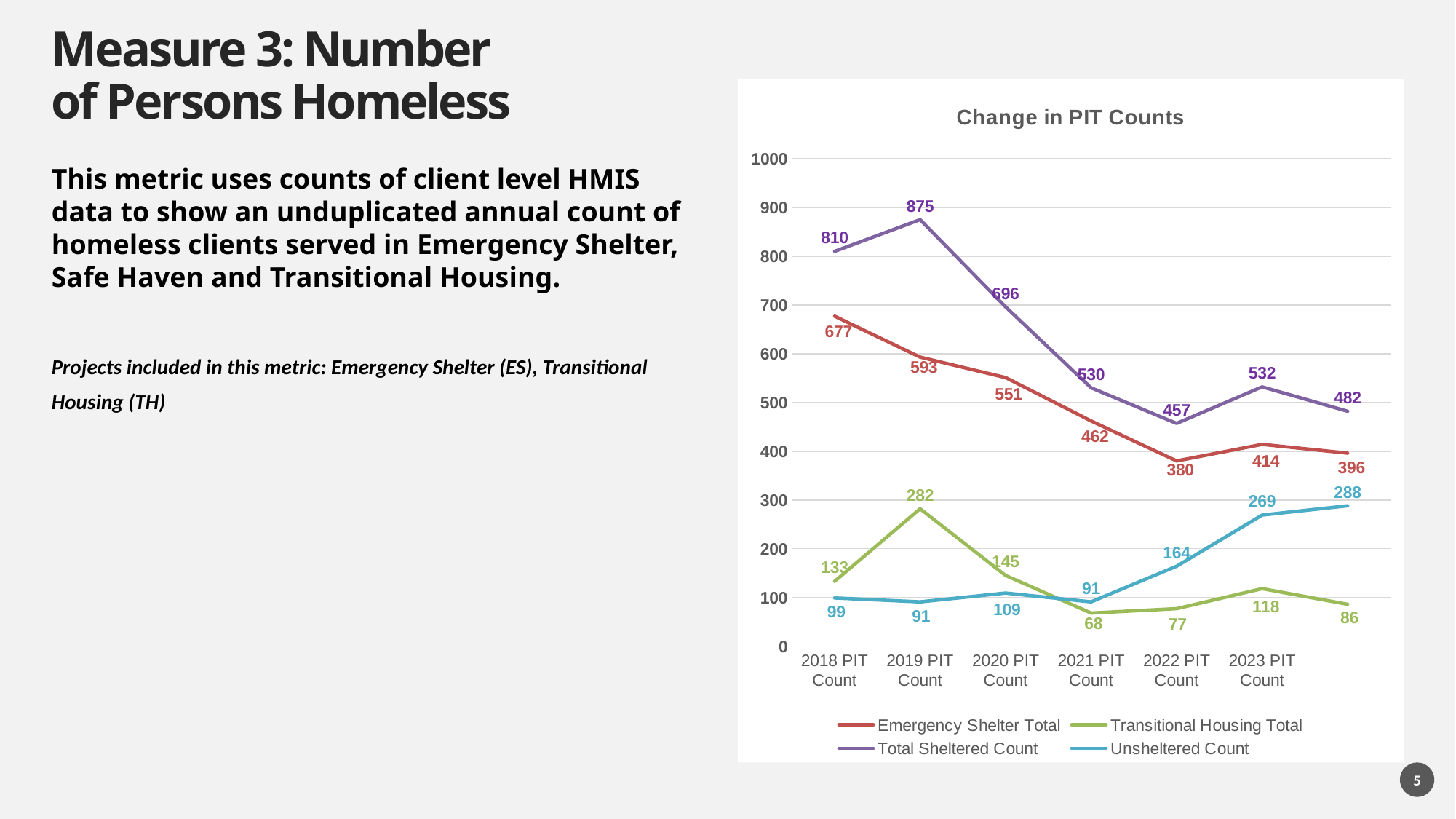
How many PIT Count years are shown on the x axis? 6 What is the Unsheltered Count for the 2023 PIT Count? 269 How many series does the legend list? 4 What is the Total Sheltered Count for the 2019 PIT Count? 875 Which is larger in the 2023 PIT Count: the Unsheltered Count or the Transitional Housing Total? Unsheltered Count What kind of chart is shown on the slide? Line chart What is the Transitional Housing Total for the 2021 PIT Count? 68 In which PIT Count year is the Total Sheltered Count highest? 2019 PIT Count In which PIT Count year is the Transitional Housing Total lowest? 2021 PIT Count What is the difference between the Total Sheltered Count in the 2018 PIT Count and the 2023 PIT Count? 278 Does the Unsheltered Count rise or fall from the 2021 PIT Count to the 2023 PIT Count? Rise What is the Emergency Shelter Total for the 2022 PIT Count? 380